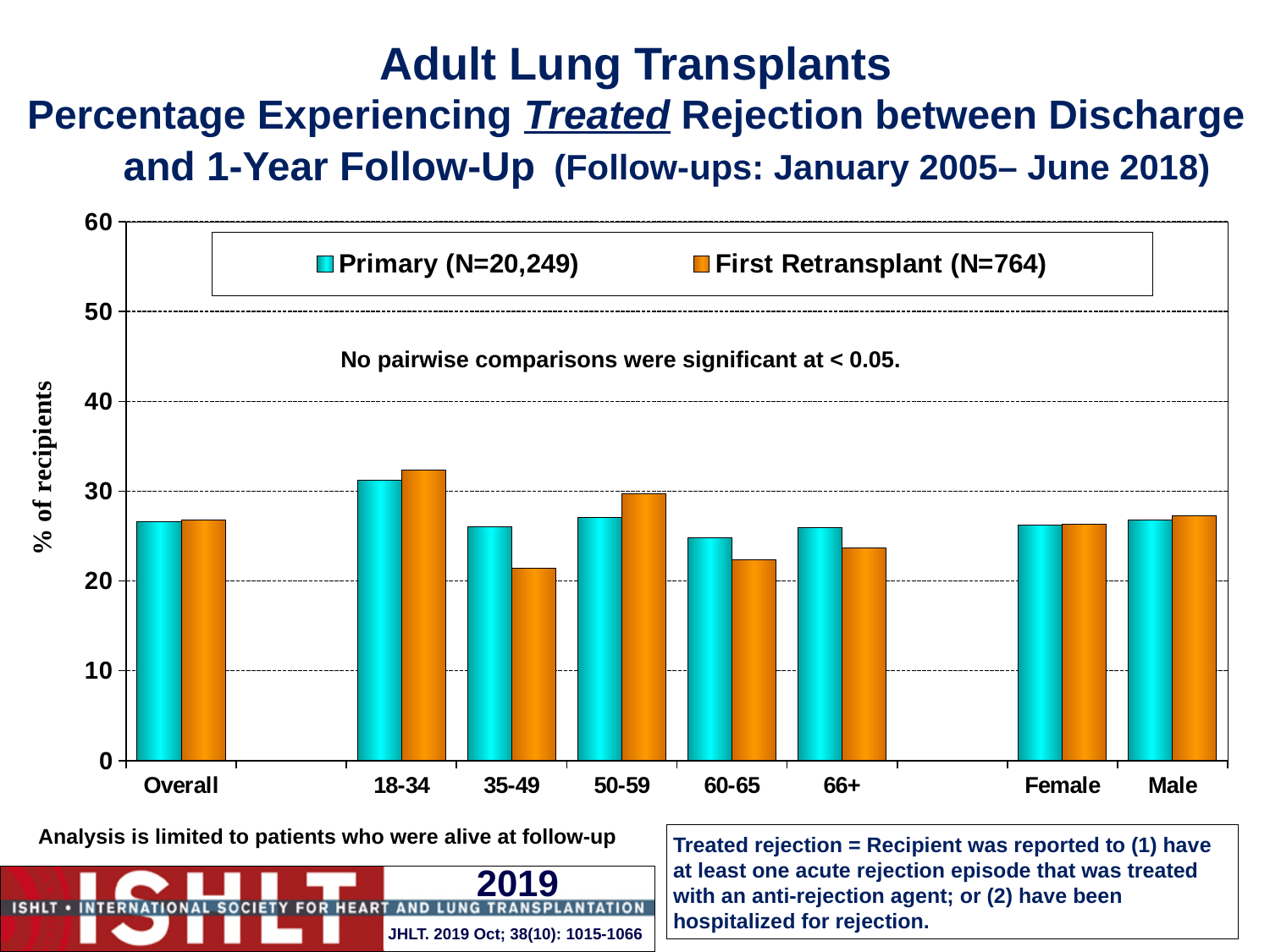
For the 50-59 age group, which series has the larger value, Primary or First Retransplant? First Retransplant How many categories are shown along the x axis? 8 How many series does the legend list? 2 Which category has the highest value for the First Retransplant series? 18-34 What is the label on the y axis? % of recipients Is the First Retransplant value for 60-65 greater or less than 20? greater Which category has the highest value for the Primary series? 18-34 What kind of chart is shown on the slide? bar chart For the 35-49 age group, which series has the larger value, Primary or First Retransplant? Primary Is the First Retransplant value for 35-49 greater or less than 30? less Is the Primary value for 18-34 greater or less than 30? greater What is the sample size (N) given in the legend for the Primary series? 20,249